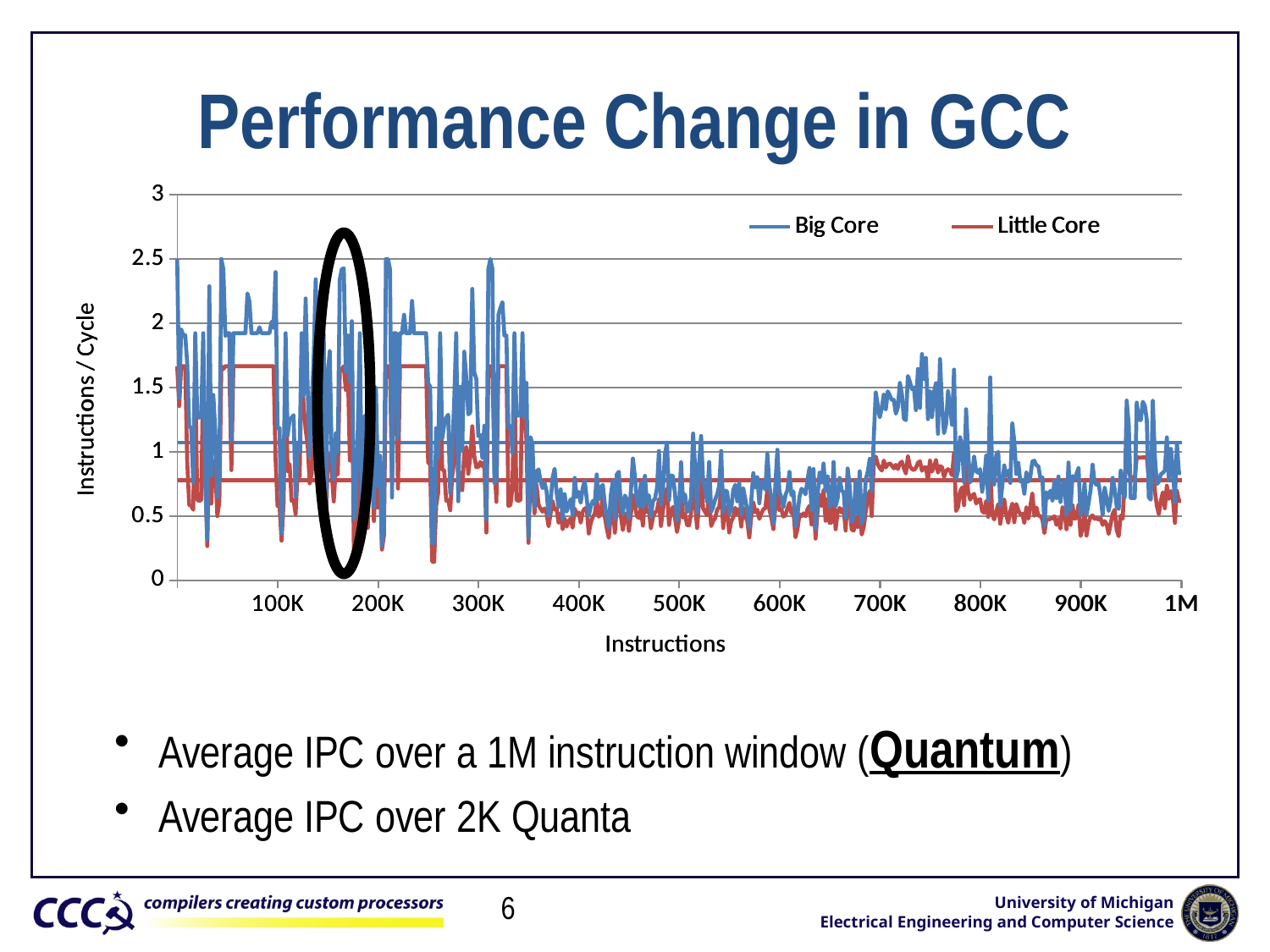
What is the label on the y axis of the chart? Instructions / Cycle What are the two series named in the legend? Big Core and Little Core Is the Little Core value at 500K instructions greater or less than 1? less Is the Big Core value at 750K instructions greater or less than 1? greater Which series reaches the higher peak values over the whole window, Big Core or Little Core? Big Core Is the Little Core value at 850K instructions greater or less than 1.5? less How many series does the legend list? 2 What kind of chart is shown on the slide? line chart Around 750K instructions, which series has the higher value, Big Core or Little Core? Big Core